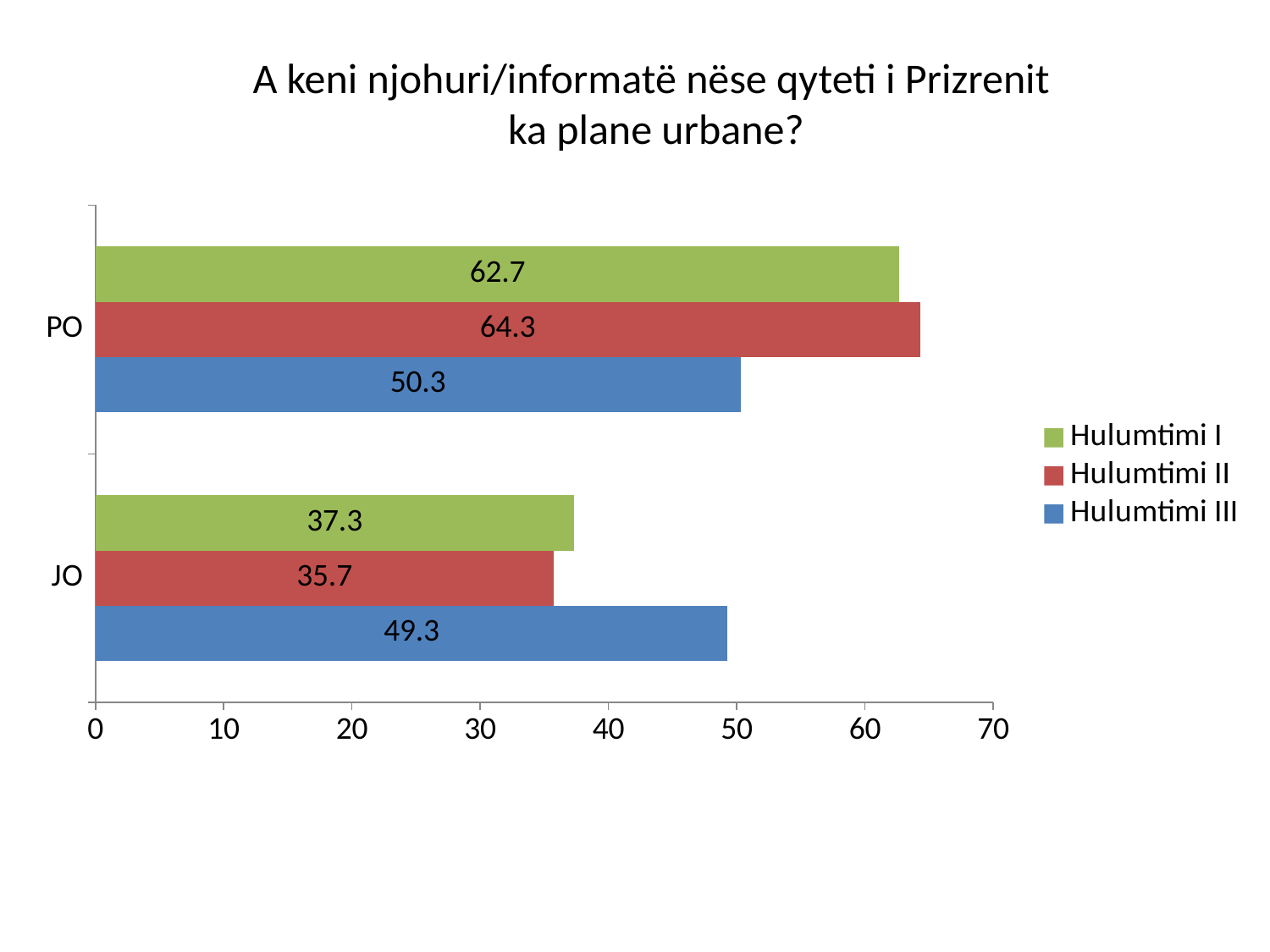
What colour represents Hulumtimi III in the chart? Blue What is the value for Hulumtimi II in the JO category? 35.7 Is the Hulumtimi III value for JO greater or less than 40? greater How many categories are shown on the vertical axis? 2 What is the value for Hulumtimi I in the PO category? 62.7 Which series has the highest value in the PO category? Hulumtimi II What is the value for Hulumtimi III in the JO category? 49.3 Which is larger: the Hulumtimi I value for PO or the Hulumtimi III value for PO? Hulumtimi I What kind of chart is shown on the slide? Bar chart How many series does the legend list? 3 Which series has the lowest value in the JO category? Hulumtimi II What is the difference between the Hulumtimi II and Hulumtimi III values in the PO category? 14